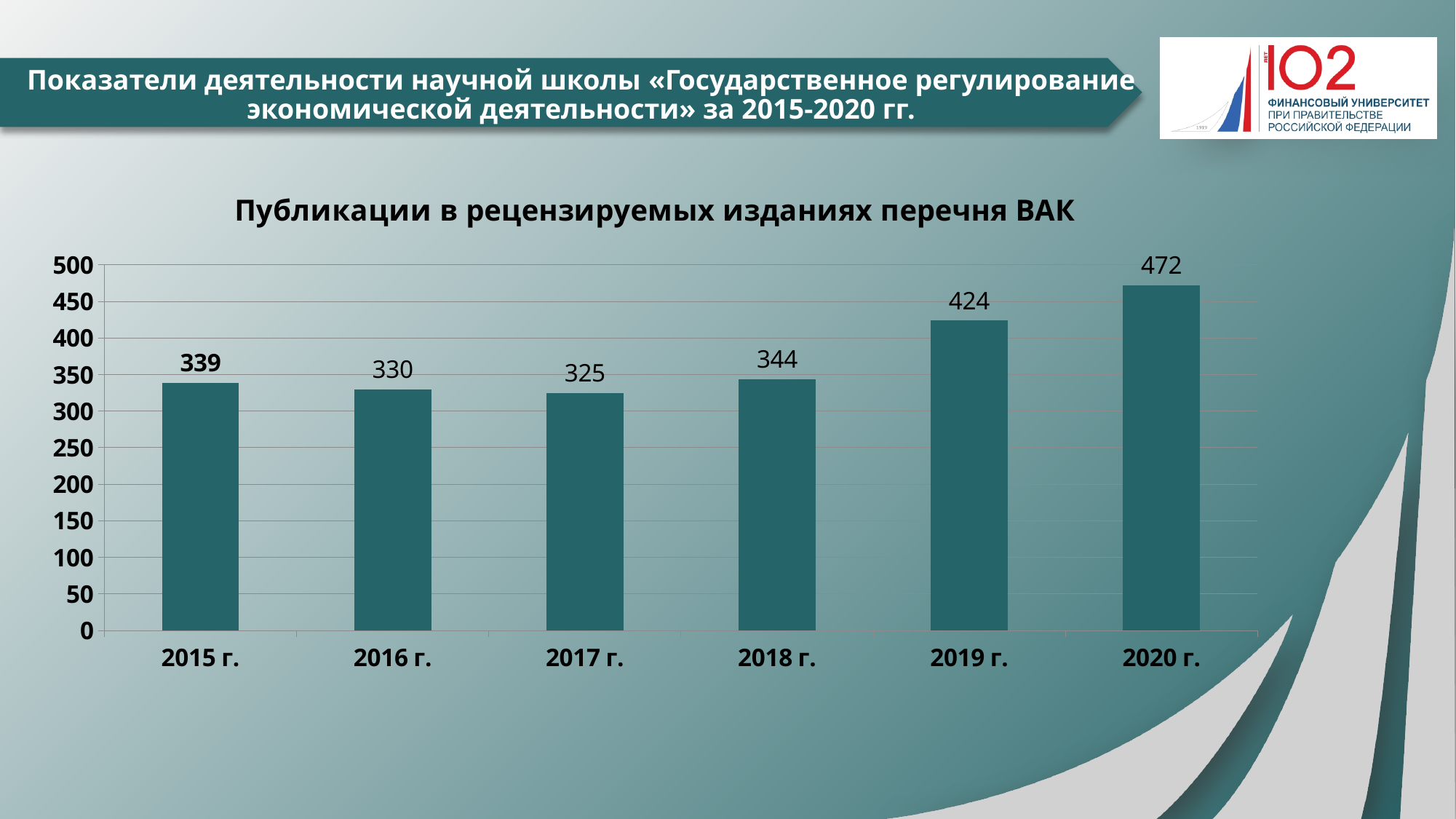
Is the value for 2019 г. greater or less than 400? greater How many years are shown on the x axis? 6 What is the difference between the values for 2020 г. and 2019 г.? 48 What is the value for 2020 г.? 472 Which year has the lowest value? 2017 г. Which is larger, the value for 2016 г. or the value for 2018 г.? 2018 г. What is the value for 2015 г.? 339 Which year has the highest value? 2020 г. What kind of chart is shown on the slide? bar chart What is the difference between the values for 2018 г. and 2017 г.? 19 What is the value for 2017 г.? 325 What is the title of the chart? Публикации в рецензируемых изданиях перечня ВАК